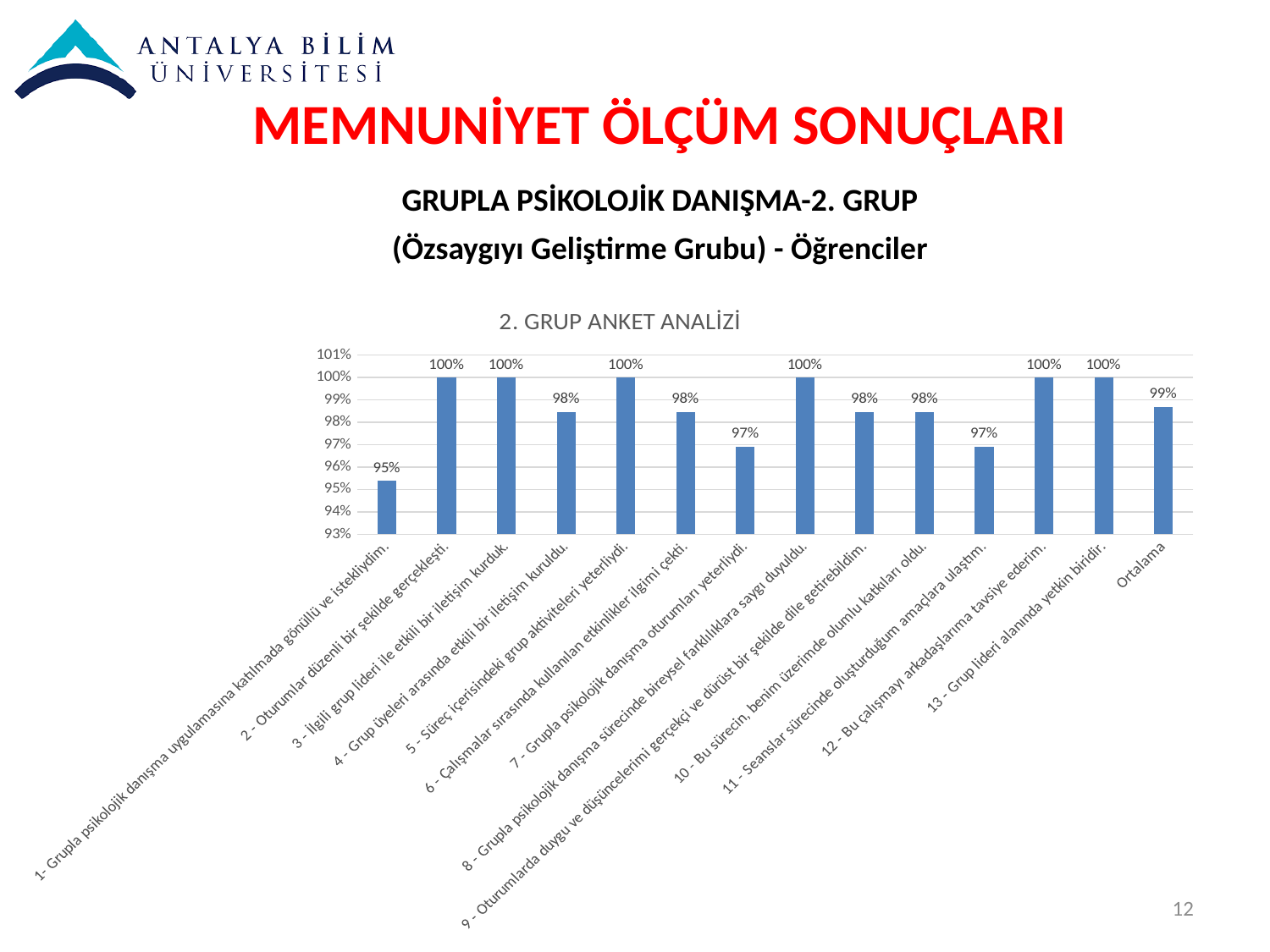
What is the value for item 7 (Grupla psikolojik danışma oturumları yeterliydi)? 97% What kind of chart is shown on the slide? bar chart Is the value for item 1 greater or less than 96%? less Which category has the lowest value in the chart? 1- Grupla psikolojik danışma uygulamasına katılmada gönüllü ve istekliydim. How many bars in the chart reach 100%? 6 What is the value for 'Ortalama'? 99% How many bars are plotted in the chart? 14 What is the difference between the value for item 2 (Oturumlar düzenli bir şekilde gerçekleşti) and item 1? 5% What is the title of the chart on the slide? 2. GRUP ANKET ANALİZİ What is the value for item 4 (Grup üyeleri arasında etkili bir iletişim kuruldu)? 98% Which is larger, the value for item 11 (Seanslar sürecinde oluşturduğum amaçlara ulaştım) or item 12 (Bu çalışmayı arkadaşlarıma tavsiye ederim)? 12 - Bu çalışmayı arkadaşlarıma tavsiye ederim. What is the value for item 1 (Grupla psikolojik danışma uygulamasına katılmada gönüllü ve istekliydim)? 95%